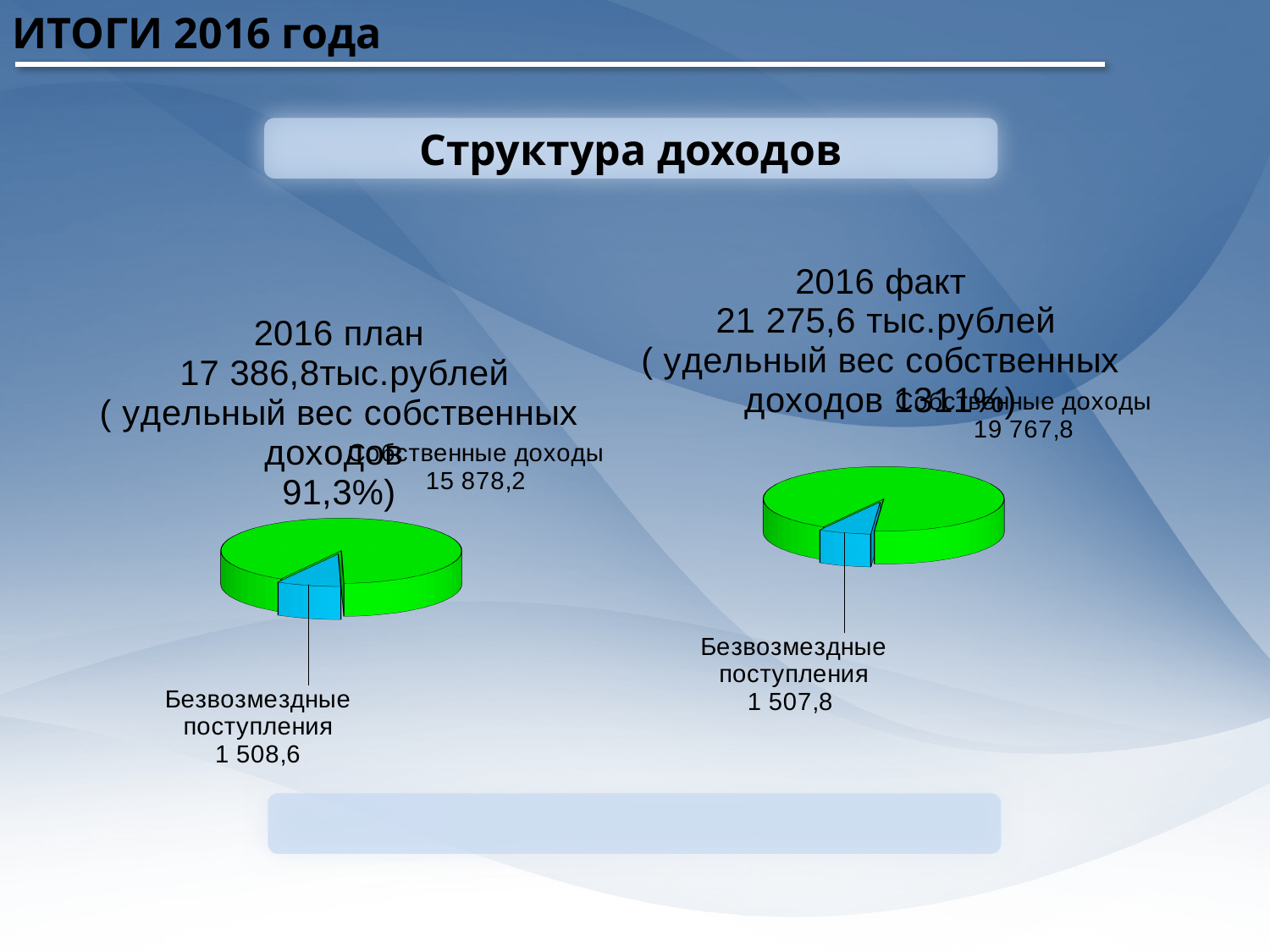
In the 2016 план pie chart, which category has the largest slice? Собственные доходы In the 2016 факт pie chart, which category has the smallest slice? Безвозмездные поступления How many slices does the 2016 план pie chart have? 2 What type of chart is used for the 2016 факт data? Pie chart In the 2016 план pie chart, what share of the total do Собственные доходы represent, as stated on the slide? 91,3% In the 2016 план pie chart, what is the difference between Собственные доходы and Безвозмездные поступления? 14 369,6 In the 2016 факт pie chart, what is the value for Собственные доходы? 19 767,8 In the 2016 план pie chart, what is the value for Безвозмездные поступления? 1 508,6 In the 2016 факт pie chart, what is the difference between Собственные доходы and Безвозмездные поступления? 18 260,0 Is the value for Собственные доходы larger in the 2016 план chart or in the 2016 факт chart? 2016 факт In the 2016 план pie chart, what is the value for Собственные доходы? 15 878,2 In the 2016 факт pie chart, what is the value for Безвозмездные поступления? 1 507,8